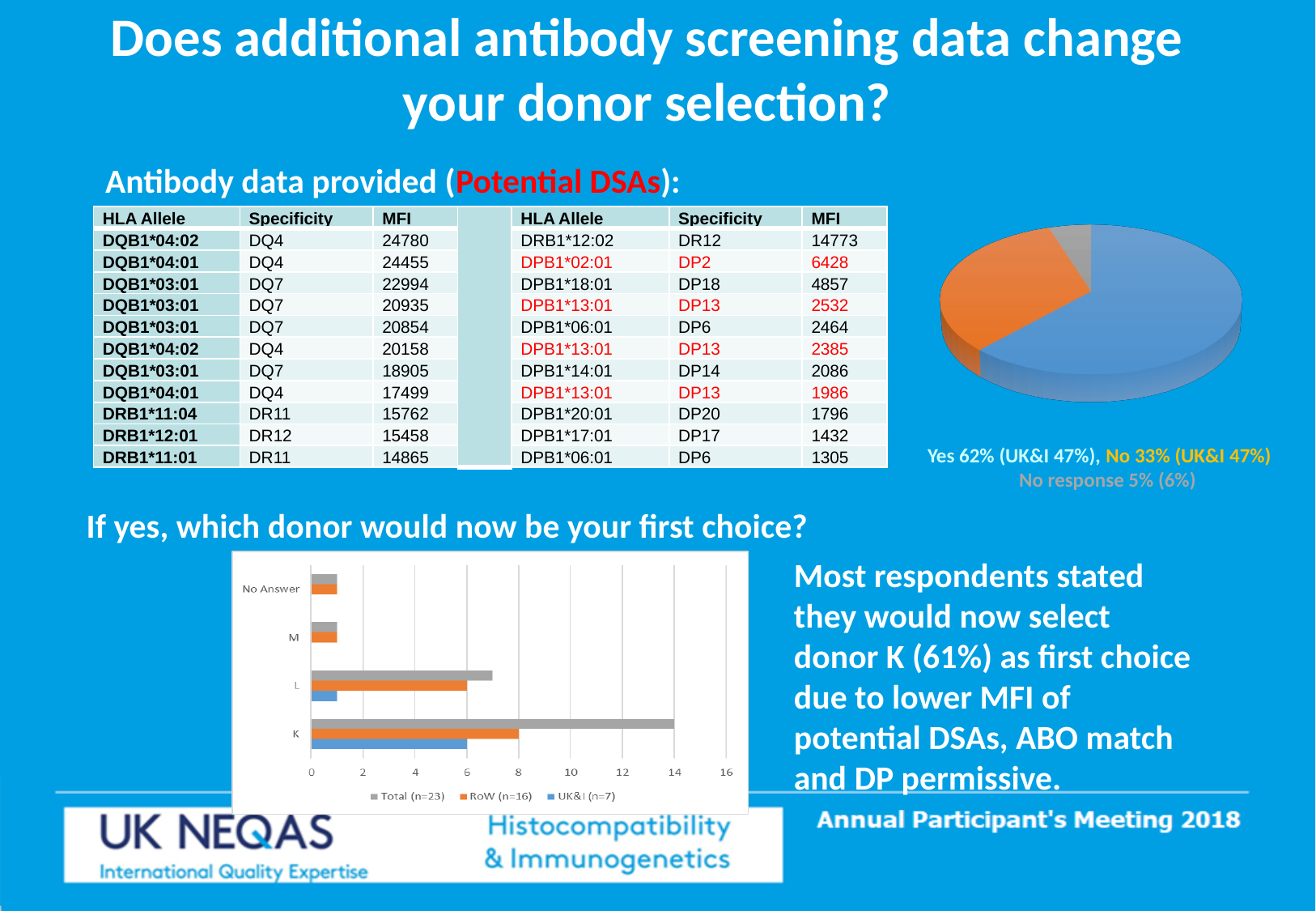
In the pie chart, what is the difference in percentage points between Yes and No? 29 In the pie chart, what percentage of respondents answered No? 33% In the bar chart, is the Total (n=23) value for donor K greater or less than 12? greater In the bar chart, how many series does the legend list? 3 In the bar chart, which donor has the highest Total (n=23) value? K In the pie chart, which response has the smallest share? No response In the bar chart, how many donor categories are shown on the vertical axis? 4 What kind of chart is the chart under 'If yes, which donor would now be your first choice?'? bar chart In the pie chart, what percentage of respondents answered Yes? 62% In the pie chart, which response has the largest share? Yes In the pie chart, what percentage gave no response? 5% In the bar chart, is the UK&I (n=7) value for donor L greater or less than 2? less